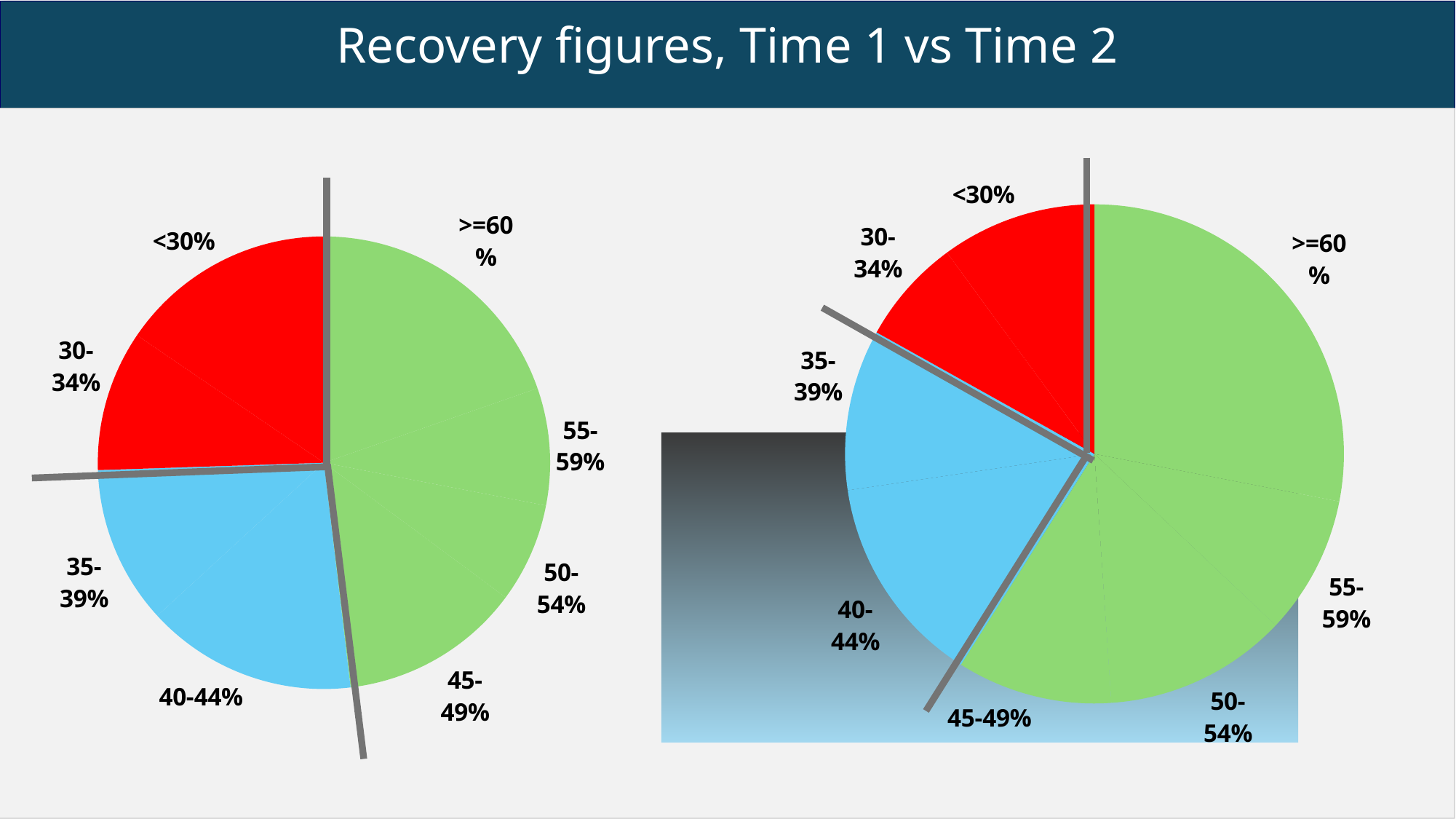
Is the combined red area (<30% and 30-34%) larger in the Time 1 chart or the Time 2 chart? Time 1 In the right chart (Time 2), which slice is larger: <30% or 30-34%? <30% How many charts are shown on the slide? 2 What is the title of the slide? Recovery figures, Time 1 vs Time 2 What kind of chart is the left chart (Time 1)? pie chart What kind of chart is the right chart (Time 2)? pie chart In the right chart (Time 2), which is larger: the <30% slice or the >=60% slice? >=60% How many categories (slices) does the right chart (Time 2) have? 8 How many categories (slices) does the left chart (Time 1) have? 8 In the left chart (Time 1), what colour is the <30% slice? red